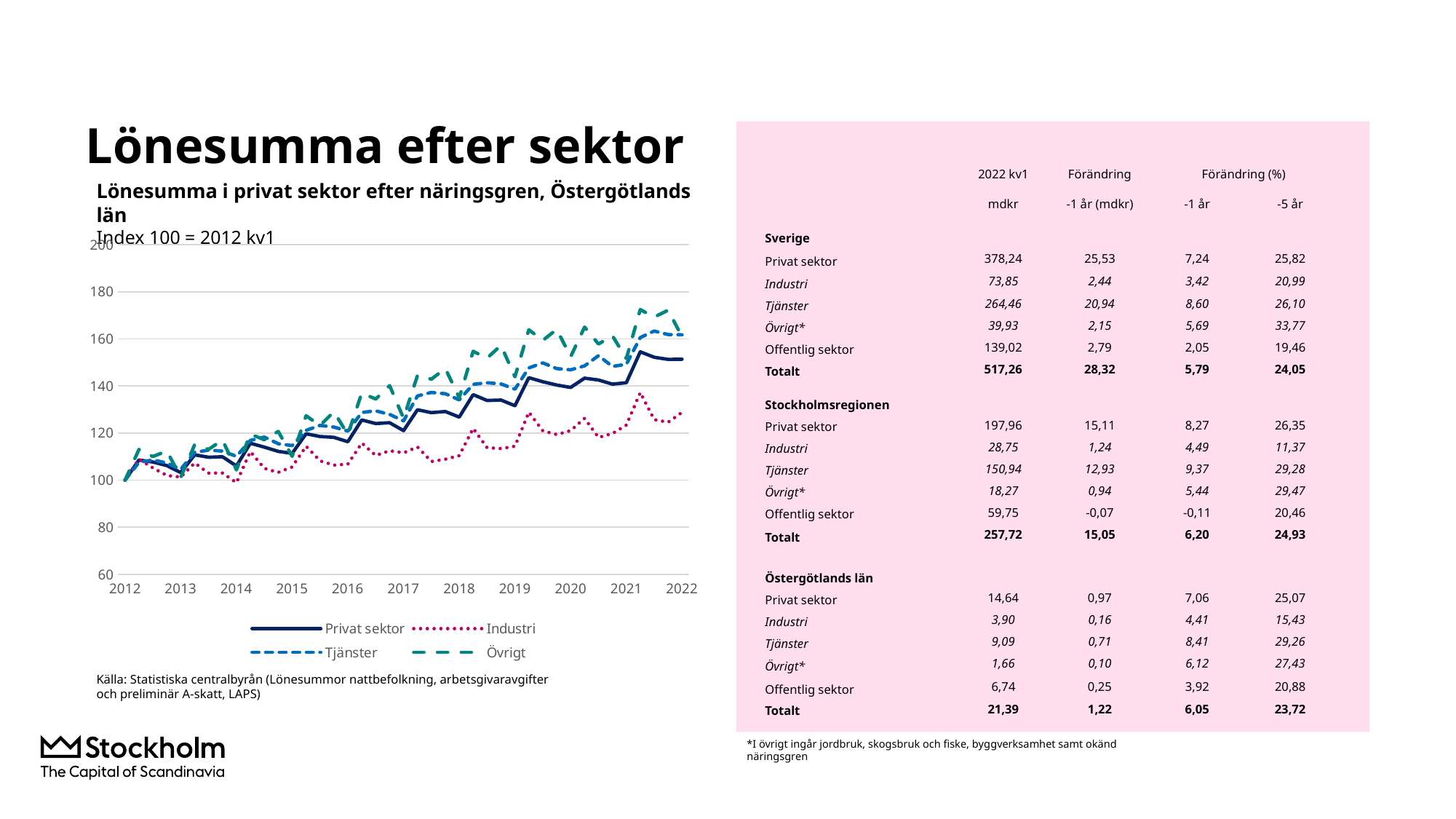
Which is higher in 2019, Privat sektor or Industri? Privat sektor Does the Privat sektor series generally rise or fall from 2012 to 2022? Rise How many year labels are shown on the x axis? 11 What is the base of the index used in the chart? Index 100 = 2012 kv1 What kind of chart is shown on the slide? Line chart Is the value for Privat sektor in 2022 greater or less than 140? greater Which series is drawn as a dotted pink line? Industri Is the value for Industri in 2022 greater or less than 140? less Which series is lowest at the end of the chart in 2022? Industri How many series does the chart legend list? 4